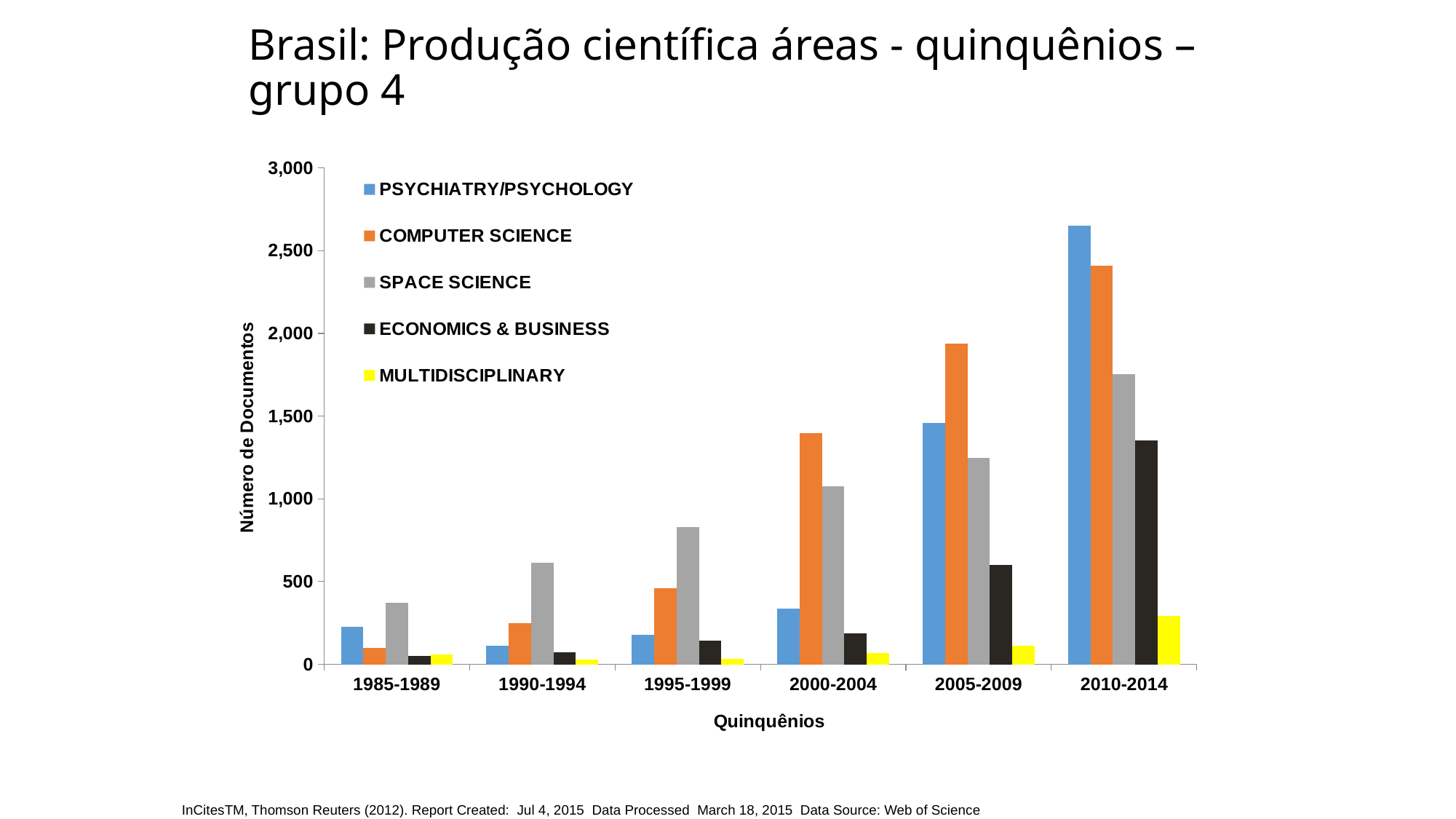
What is the title of the y axis? Número de Documentos Is the value for PSYCHIATRY/PSYCHOLOGY in 2010-2014 greater or less than 2,500? greater What kind of chart is shown on the slide? Bar chart Is the value for COMPUTER SCIENCE in 2005-2009 greater or less than 1,500? greater In the 2000-2004 period, which is larger: COMPUTER SCIENCE or SPACE SCIENCE? COMPUTER SCIENCE How many quinquennia (periods) are shown on the x axis? 6 How many series does the legend list? 5 Which series has the lowest value in the 2010-2014 period? MULTIDISCIPLINARY Which series has the highest value in the 2010-2014 period? PSYCHIATRY/PSYCHOLOGY Is the value for SPACE SCIENCE in 2010-2014 greater or less than 2,000? less Do the values for ECONOMICS & BUSINESS rise or fall from 1985-1989 to 2010-2014? rise Which series has the highest value in the 1995-1999 period? SPACE SCIENCE